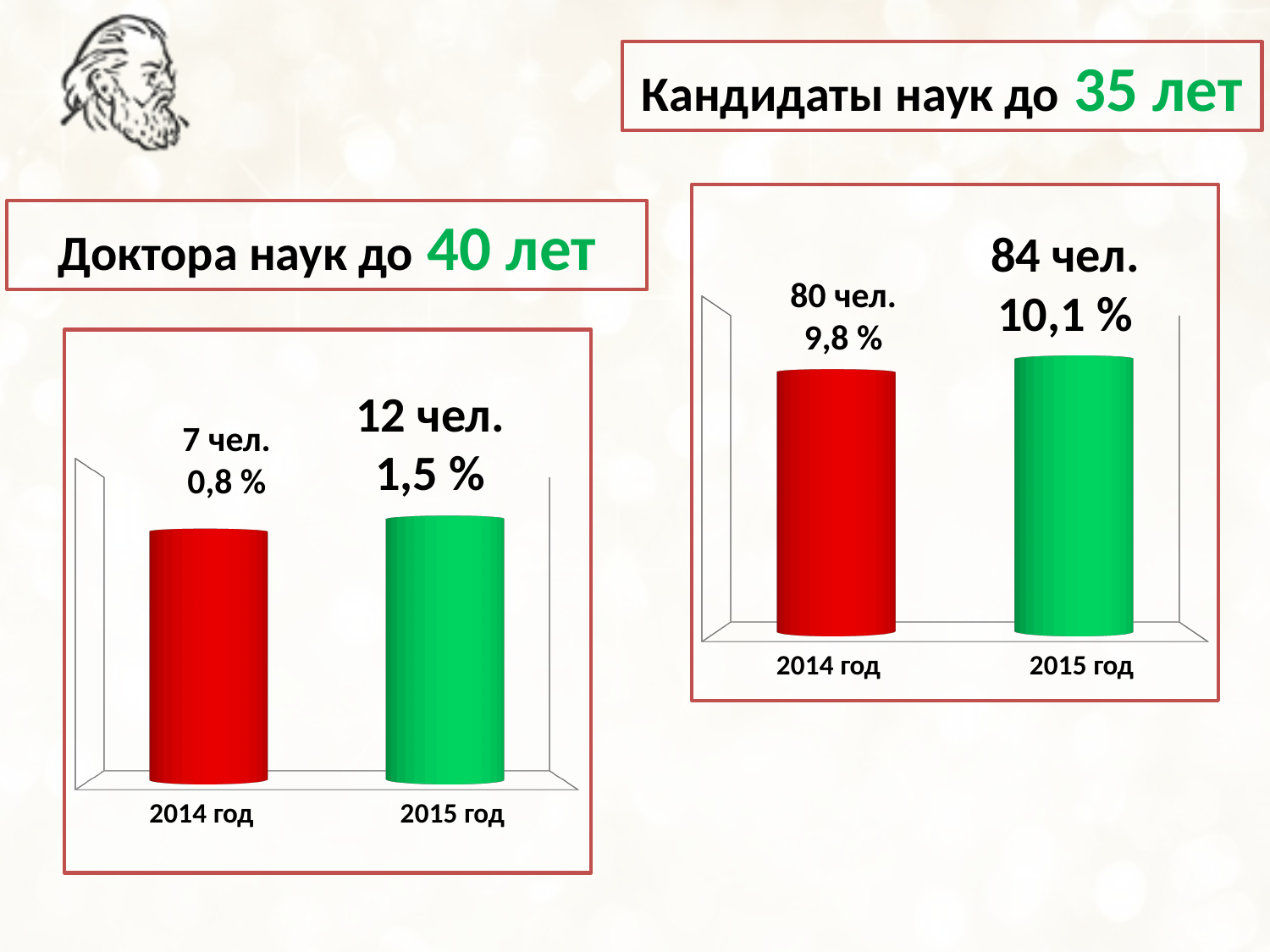
In the chart titled "Кандидаты наук до 35 лет", which year has the lower value? 2014 год How many categories (years) does the chart titled "Доктора наук до 40 лет" show? 2 In the chart titled "Доктора наук до 40 лет", which year has the higher value? 2015 год In the chart titled "Кандидаты наук до 35 лет", how many people are shown for 2014 год? 80 чел. In the chart titled "Доктора наук до 40 лет", what percentage is shown for 2015 год? 1,5 % In the chart titled "Кандидаты наук до 35 лет", what percentage is shown for 2015 год? 10,1 % In the chart titled "Кандидаты наук до 35 лет", is the value for 2014 год or 2015 год larger? 2015 год In the chart titled "Доктора наук до 40 лет", do the values rise or fall from 2014 год to 2015 год? Rise In the chart titled "Доктора наук до 40 лет", how many people are shown for 2014 год? 7 чел. In the chart titled "Доктора наук до 40 лет", by how many people did the count increase from 2014 год to 2015 год? 5 In the chart titled "Кандидаты наук до 35 лет", what is the difference in people between 2015 год and 2014 год? 4 What kind of chart is the chart titled "Кандидаты наук до 35 лет"? Bar chart